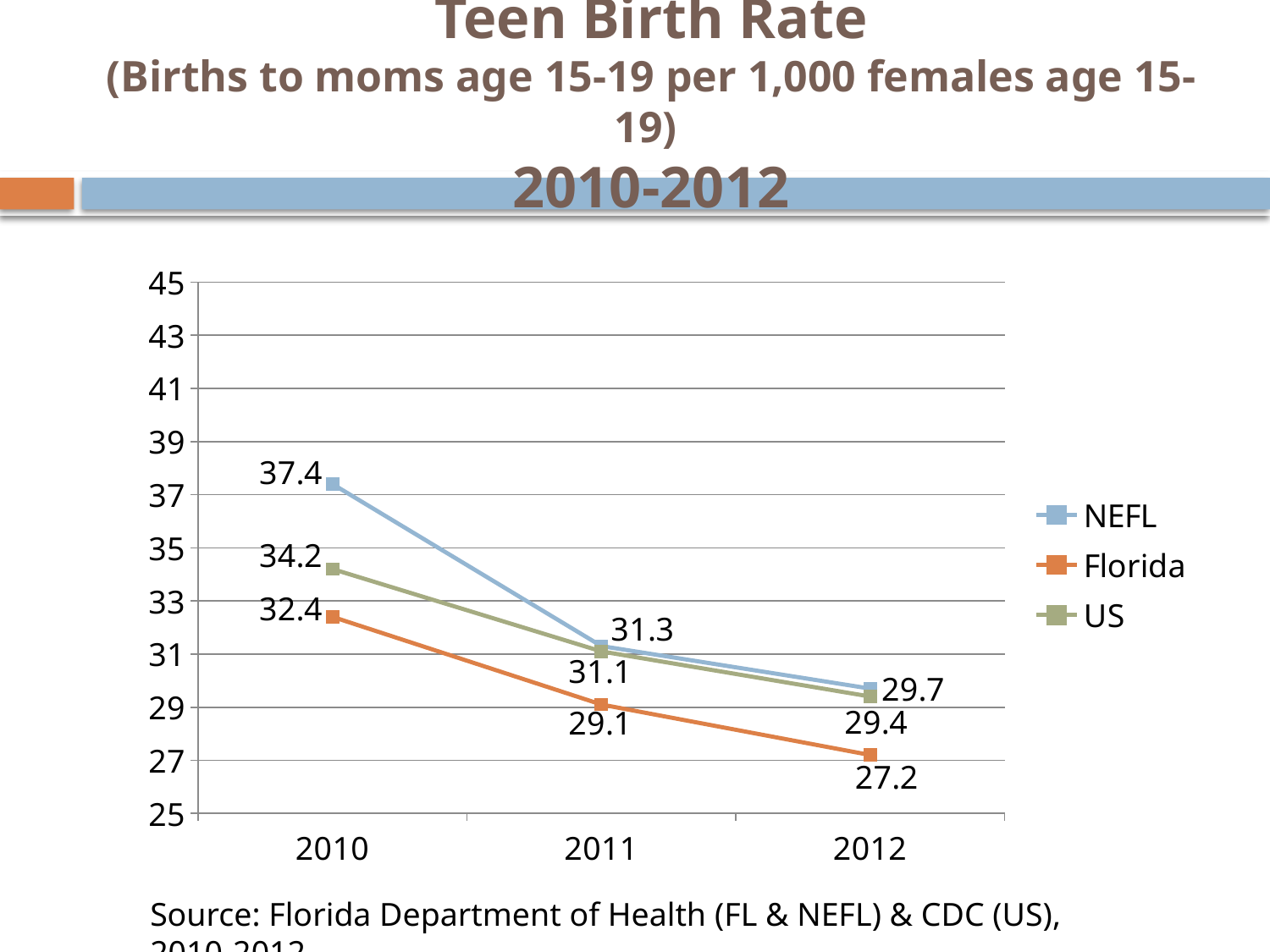
What was the Florida teen birth rate in 2012? 27.2 What was the Florida teen birth rate in 2011? 29.1 How many series does the legend list? 3 Which series had the lowest teen birth rate in 2012? Florida What was the NEFL teen birth rate in 2010? 37.4 What kind of chart is shown on the slide? Line chart Which series had the highest teen birth rate in 2010? NEFL How many years are shown on the x axis? 3 What was the US teen birth rate in 2011? 31.1 What is the difference between the NEFL teen birth rate in 2010 and in 2012? 7.7 Does the Florida teen birth rate rise or fall from 2010 to 2012? Fall Which was larger in 2010, the US rate or the Florida rate? US